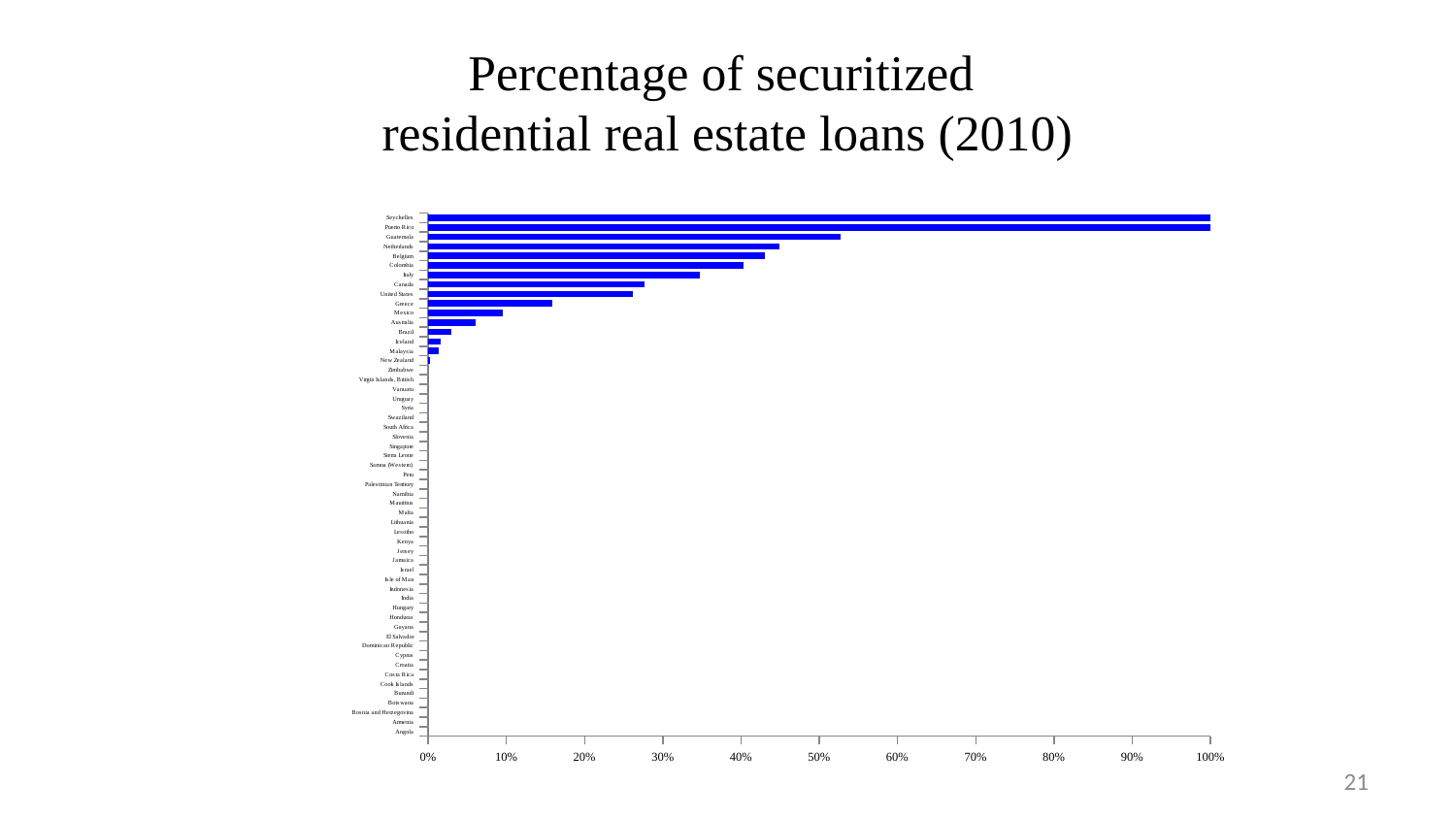
Is the value for Italy greater or less than 40%? less Is the value for Canada greater or less than 30%? less Is the value for Netherlands greater or less than 50%? less Which has a larger value, Mexico or Greece? Greece Which has a larger value, Guatemala or Netherlands? Guatemala What is the title of the chart? Percentage of securitized residential real estate loans (2010) Which has a larger value, Italy or Canada? Italy What kind of chart is shown on the slide? bar chart What is the value for Seychelles? 100%